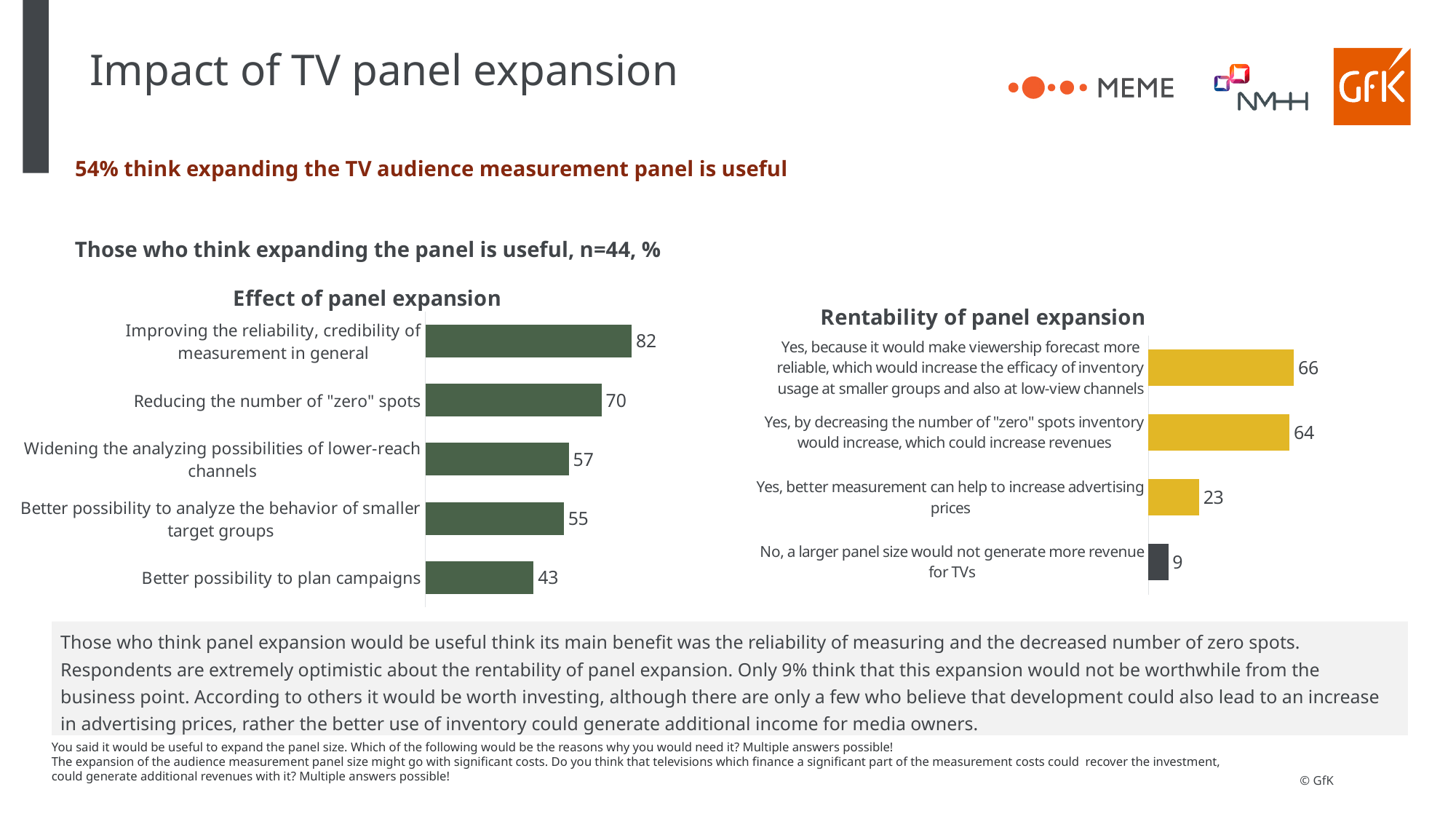
In the 'Effect of panel expansion' chart, what is the value for 'Reducing the number of "zero" spots'? 70 In the 'Rentability of panel expansion' chart, what is the difference between the values for 'Yes, by decreasing the number of "zero" spots inventory would increase, which could increase revenues' and 'Yes, better measurement can help to increase advertising prices'? 41 In the 'Effect of panel expansion' chart, what is the difference between the values for 'Improving the reliability, credibility of measurement in general' and 'Better possibility to plan campaigns'? 39 In the 'Rentability of panel expansion' chart, how many categories are shown? 4 In the 'Effect of panel expansion' chart, which category has the lowest value? Better possibility to plan campaigns In the 'Effect of panel expansion' chart, which category has the highest value? Improving the reliability, credibility of measurement in general In the 'Rentability of panel expansion' chart, what is the value for 'No, a larger panel size would not generate more revenue for TVs'? 9 In the 'Rentability of panel expansion' chart, what is the value for 'Yes, better measurement can help to increase advertising prices'? 23 What kind of chart is the 'Effect of panel expansion' chart? Bar chart In the 'Rentability of panel expansion' chart, which category has the lowest value? No, a larger panel size would not generate more revenue for TVs Which is larger: the value for 'Widening the analyzing possibilities of lower-reach channels' in the 'Effect of panel expansion' chart or the value for 'Yes, because it would make viewership forecast more reliable, which would increase the efficacy of inventory usage at smaller groups and also at low-view channels' in the 'Rentability of panel expansion' chart? Yes, because it would make viewership forecast more reliable, which would increase the efficacy of inventory usage at smaller groups and also at low-view channels In the 'Effect of panel expansion' chart, how many categories are shown? 5